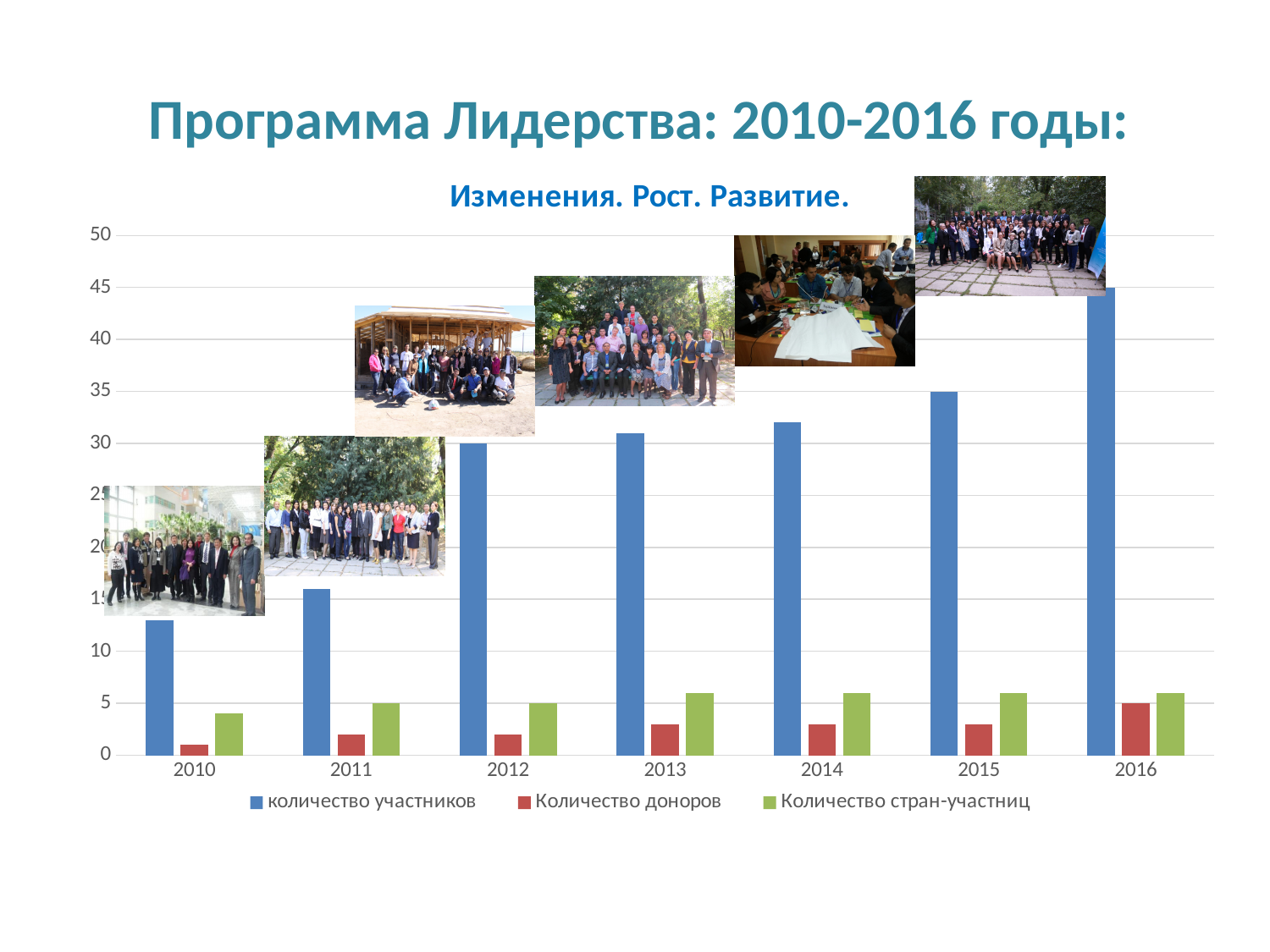
Which year has the lowest value for количество участников? 2010 What is the value of количество участников for 2012? 30 Is the value for количество участников in 2010 greater or less than 15? less What is the value of Количество доноров for 2016? 5 Which year has the highest value for количество участников? 2016 What is the value of количество участников for 2016? 45 Is the value for количество участников in 2014 greater or less than 30? greater What kind of chart is shown on the slide? bar chart Which is larger in 2016: Количество доноров or Количество стран-участниц? Количество стран-участниц Does количество участников rise or fall from 2010 to 2016? rise How many years are shown on the x axis? 7 How many series does the legend list? 3